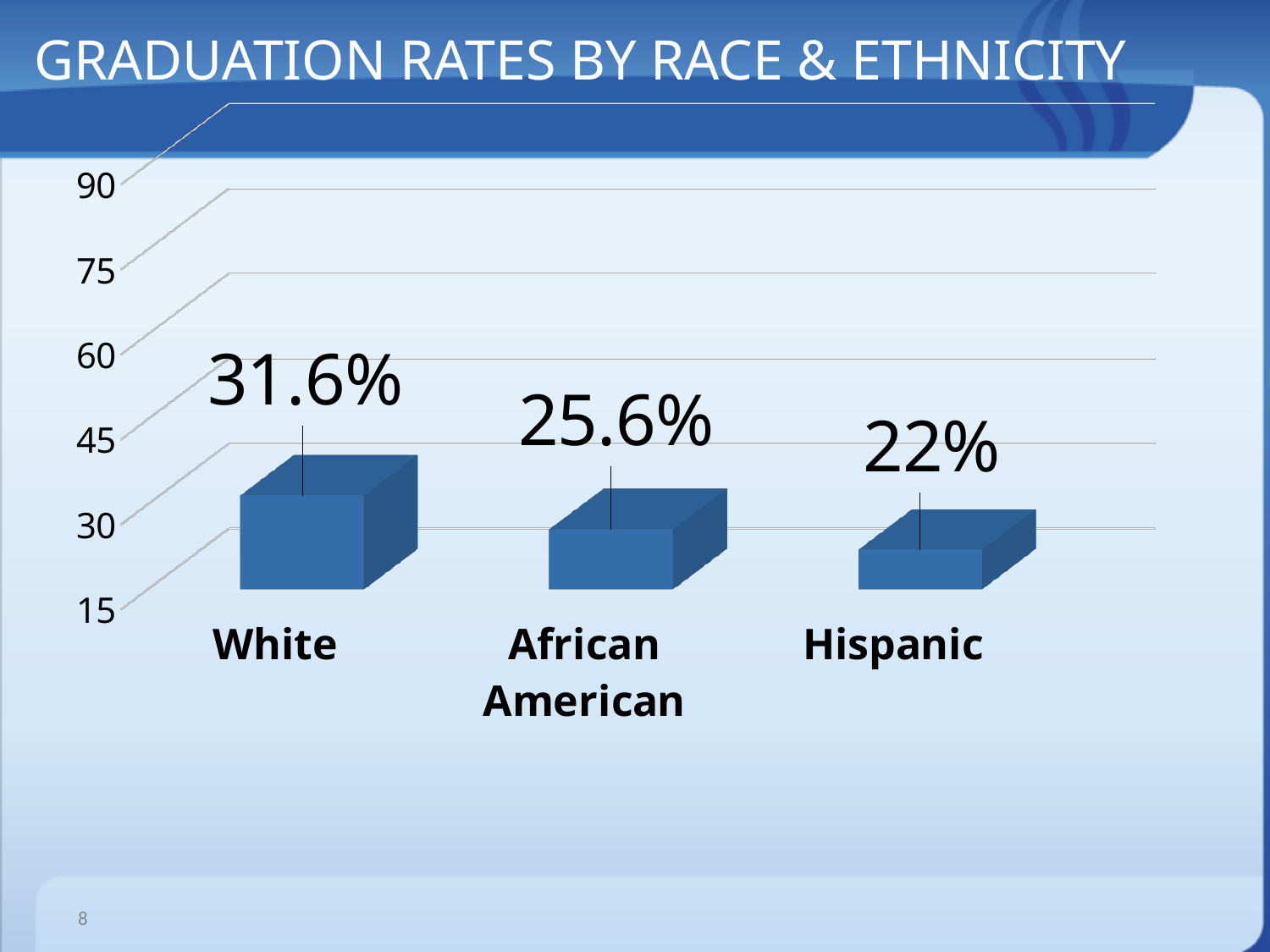
What is the difference between the graduation rates for White and Hispanic students? 9.6% What is the graduation rate for African American students? 25.6% Which is larger, the graduation rate for African American students or for Hispanic students? African American What is the difference between the graduation rates for White and African American students? 6% What is the graduation rate for White students? 31.6% How many groups are shown in the chart? 3 Which group has the highest graduation rate? White Which group has the lowest graduation rate? Hispanic What is the graduation rate for Hispanic students? 22% Is the graduation rate for White students greater or less than 30? greater What is the title of the slide? Graduation Rates by Race & Ethnicity What kind of chart is shown on the slide? Bar chart